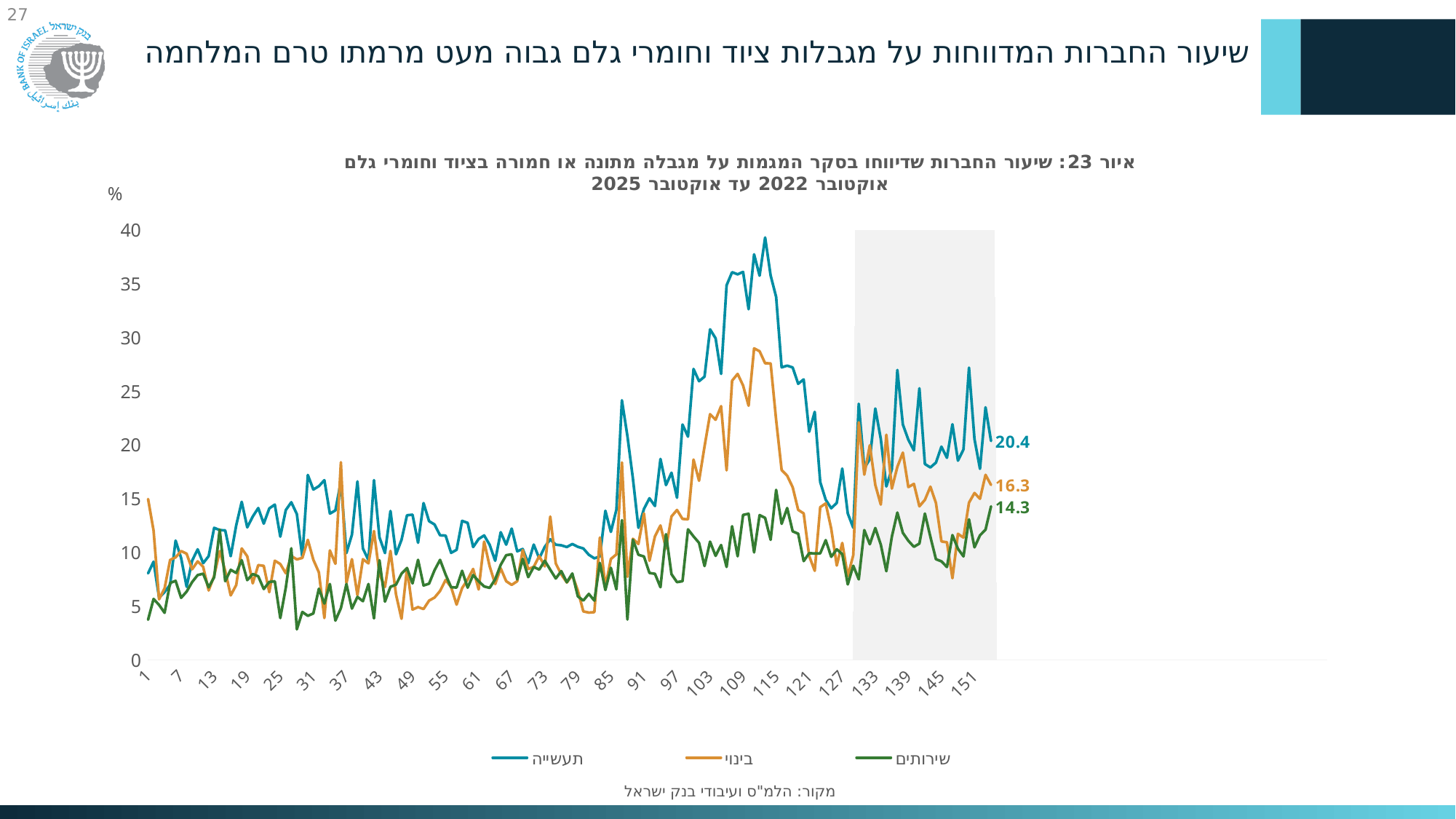
Which series is drawn in green? שירותים What kind of chart is shown on the slide? line chart What is the final labelled value for the בינוי series? 16.3 What is the difference between the final labelled values of תעשייה and שירותים? 6.1 How many series does the legend list? 3 What is the final labelled value for the שירותים series? 14.3 What is the final labelled value for the תעשייה series? 20.4 Is the final labelled value for בינוי greater or less than 15? greater Which series has the lowest final labelled value? שירותים What is the difference between the final labelled values of בינוי and שירותים? 2.0 Which series has the highest final labelled value? תעשייה Is the peak of the תעשייה series greater or less than 35? greater